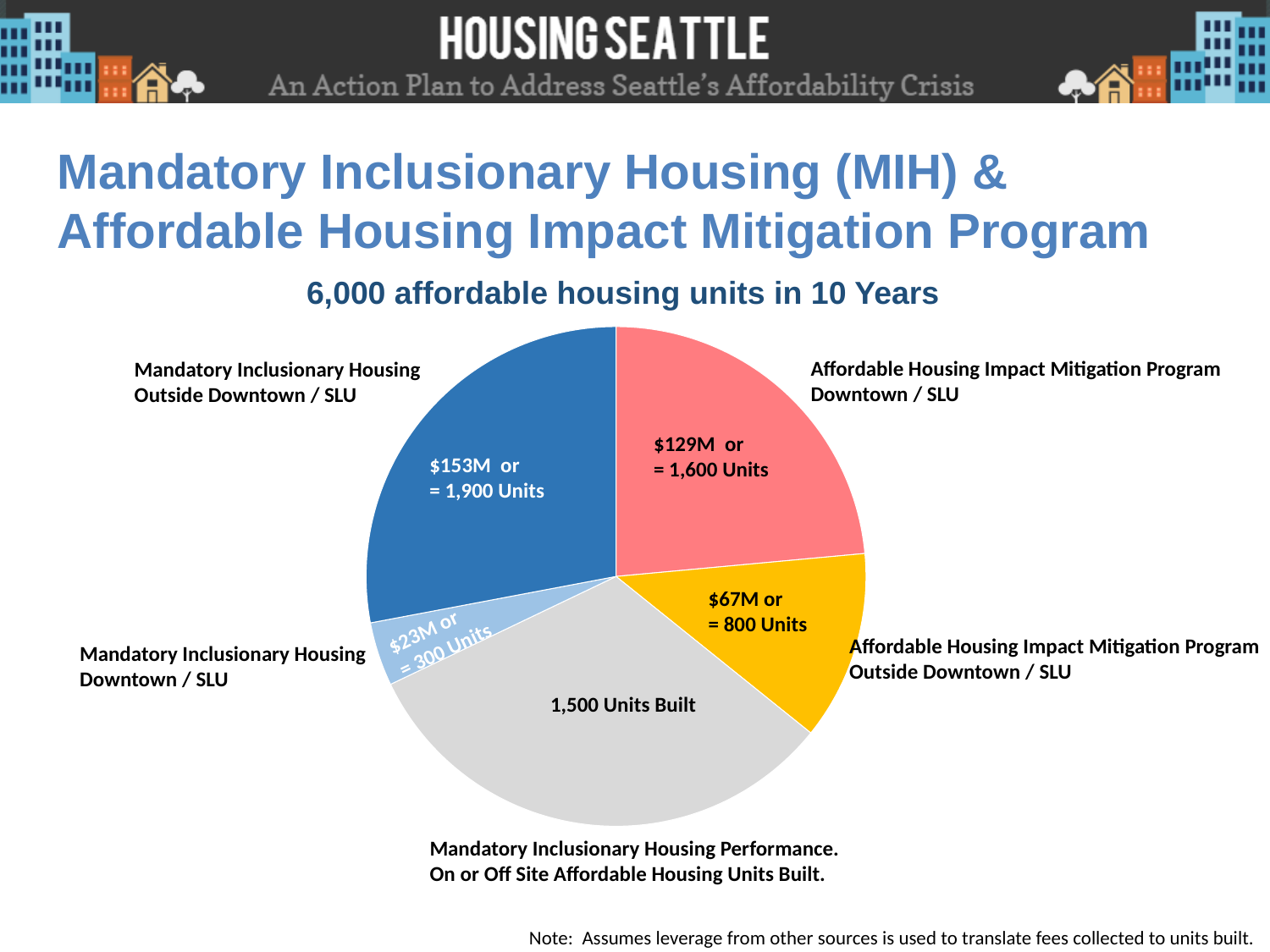
Which slice represents the smallest number of units? Mandatory Inclusionary Housing Downtown / SLU What dollar amount is shown for the Mandatory Inclusionary Housing Downtown / SLU slice? $23M How many units are shown for the Mandatory Inclusionary Housing Performance (On or Off Site Affordable Housing Units Built) slice? 1,500 Units Built How many more units does the Mandatory Inclusionary Housing Outside Downtown / SLU slice represent than the Affordable Housing Impact Mitigation Program Downtown / SLU slice? 300 Units Which slice represents the largest number of units? Mandatory Inclusionary Housing Outside Downtown / SLU Which represents more units: Affordable Housing Impact Mitigation Program Outside Downtown / SLU or Mandatory Inclusionary Housing Downtown / SLU? Affordable Housing Impact Mitigation Program Outside Downtown / SLU How many units does the Mandatory Inclusionary Housing Outside Downtown / SLU slice represent? 1,900 Units What kind of chart is shown on the slide? Pie chart How many units are shown for the Affordable Housing Impact Mitigation Program Outside Downtown / SLU slice? 800 Units How many slices does the pie chart have? 5 What share of the 6,000 total units does the 1,500 Units Built slice represent? 25% What dollar amount is shown for the Affordable Housing Impact Mitigation Program Downtown / SLU slice? $129M